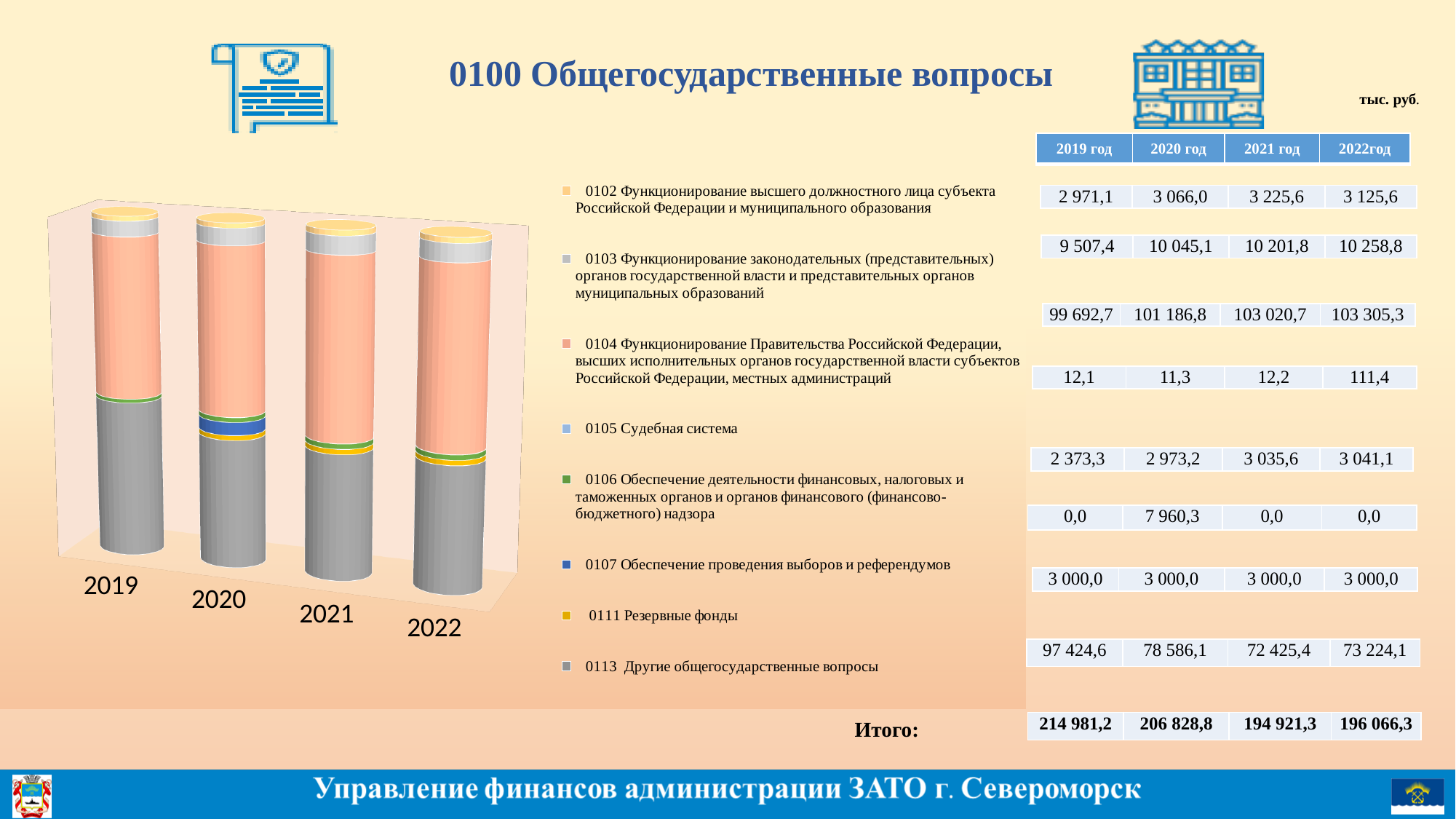
How many years (categories) are plotted on the x axis of the chart? 4 Which year has the highest total (Итого)? 2019 What is the value for 0104 (Функционирование Правительства Российской Федерации...) in 2021? 103 020,7 Which year has the lowest total (Итого)? 2021 What is the difference between the 0111 Резервные фонды value in 2022 and in 2019? 0,0 Which series is shown in the dark blue colour in the legend? 0107 Обеспечение проведения выборов и референдумов What is the value for 0107 Обеспечение проведения выборов и референдумов in 2020? 7 960,3 What is the total (Итого) for 2022? 196 066,3 How many series does the chart legend list? 8 What is the value for 0113 Другие общегосударственные вопросы in 2019? 97 424,6 Which is larger: the value for 0104 in 2019 or the value for 0113 in 2019? 0104 in 2019 What kind of chart is shown on the slide? Stacked bar chart